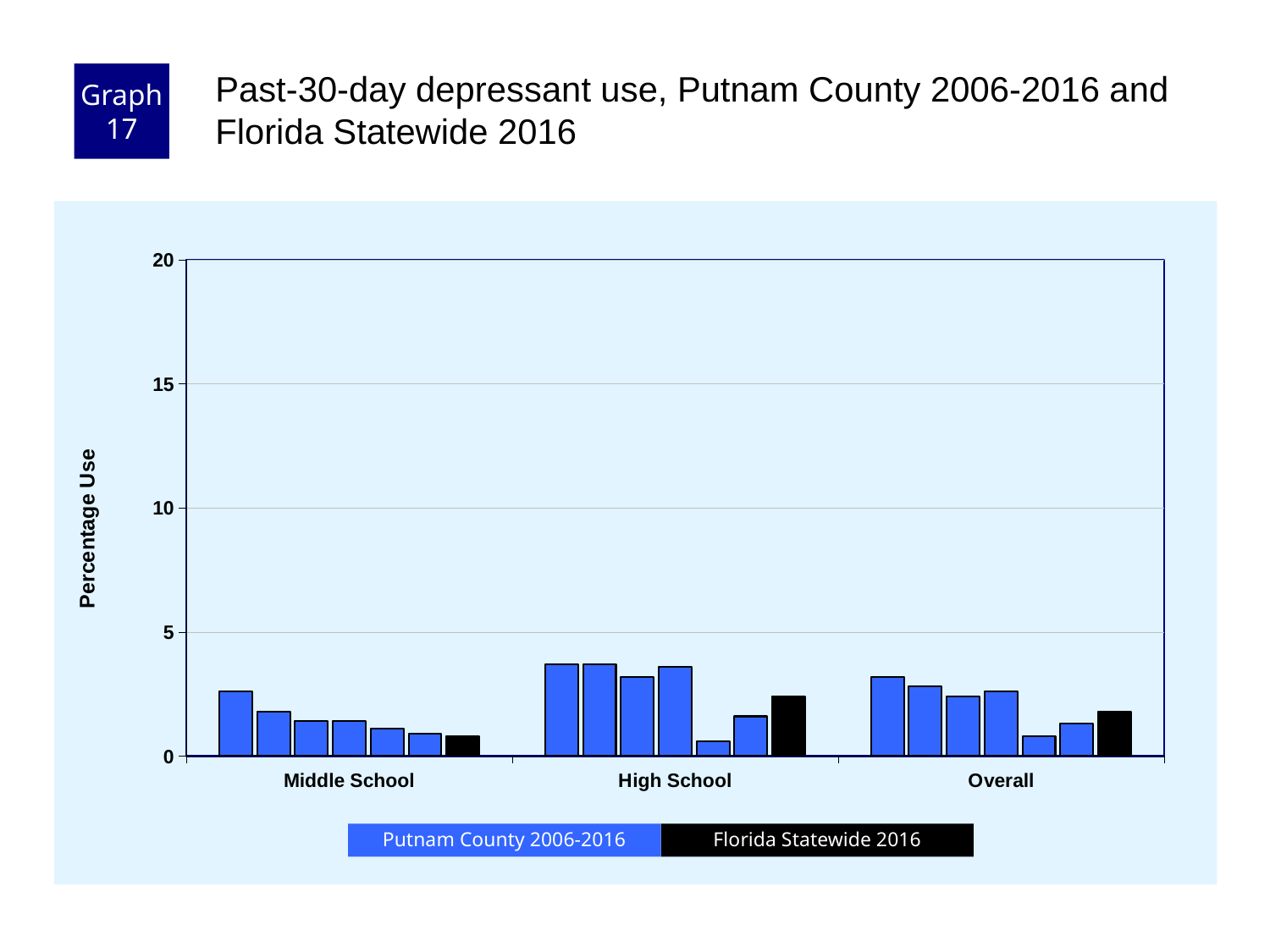
Which colour represents Florida Statewide 2016 in the chart? black Which group contains the tallest bar in the chart? High School How many category groups are shown on the x axis? 3 Which group has the higher Florida Statewide 2016 bar, Middle School or High School? High School Is the Florida Statewide 2016 value for High School greater or less than 5? less How many series does the legend list? 2 Which group has the lowest Florida Statewide 2016 bar? Middle School What kind of chart is shown on the slide? bar chart Is the tallest Putnam County bar in the High School group greater or less than 5? less Is the Florida Statewide 2016 value for Middle School greater or less than 5? less Do the Putnam County bars in the Middle School group generally rise or fall from left to right? fall What is the label of the y axis? Percentage Use